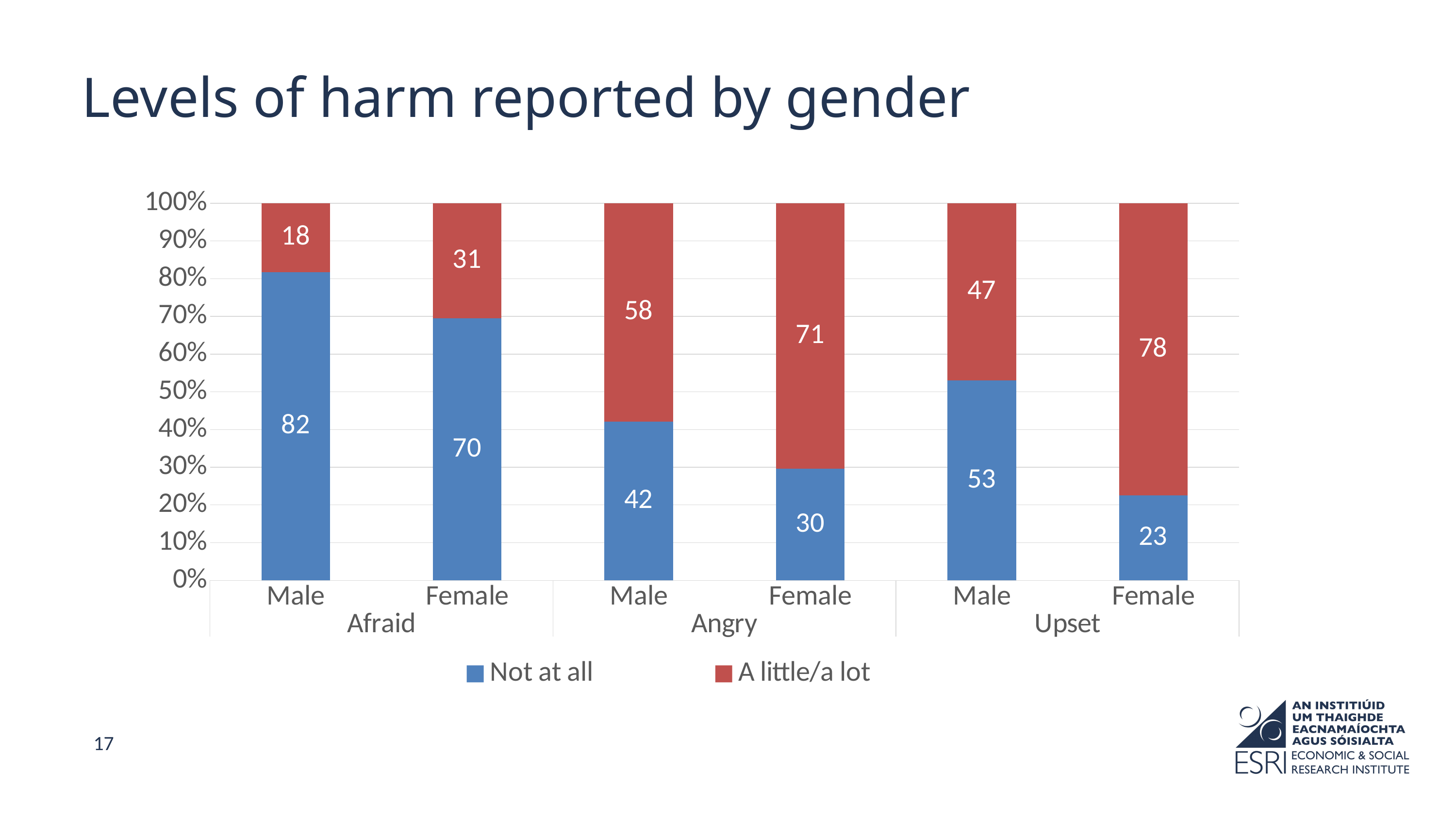
How many bars are plotted in the chart? 6 What is the 'Not at all' value for Male in the Afraid group? 82 Which bar has the highest 'Not at all' value? Male, Afraid Which bar has the lowest 'A little/a lot' value? Male, Afraid Which is larger: the 'Not at all' value for Male in the Angry group or for Male in the Upset group? Male in the Upset group What is the 'A little/a lot' value for Male in the Angry group? 58 What is the 'A little/a lot' value for Female in the Upset group? 78 What is the title of the chart on the slide? Levels of harm reported by gender How many series does the legend list? 2 What is the difference between the 'A little/a lot' values for Female and Male in the Upset group? 31 What is the 'Not at all' value for Female in the Angry group? 30 What kind of chart is shown on the slide? Stacked bar chart